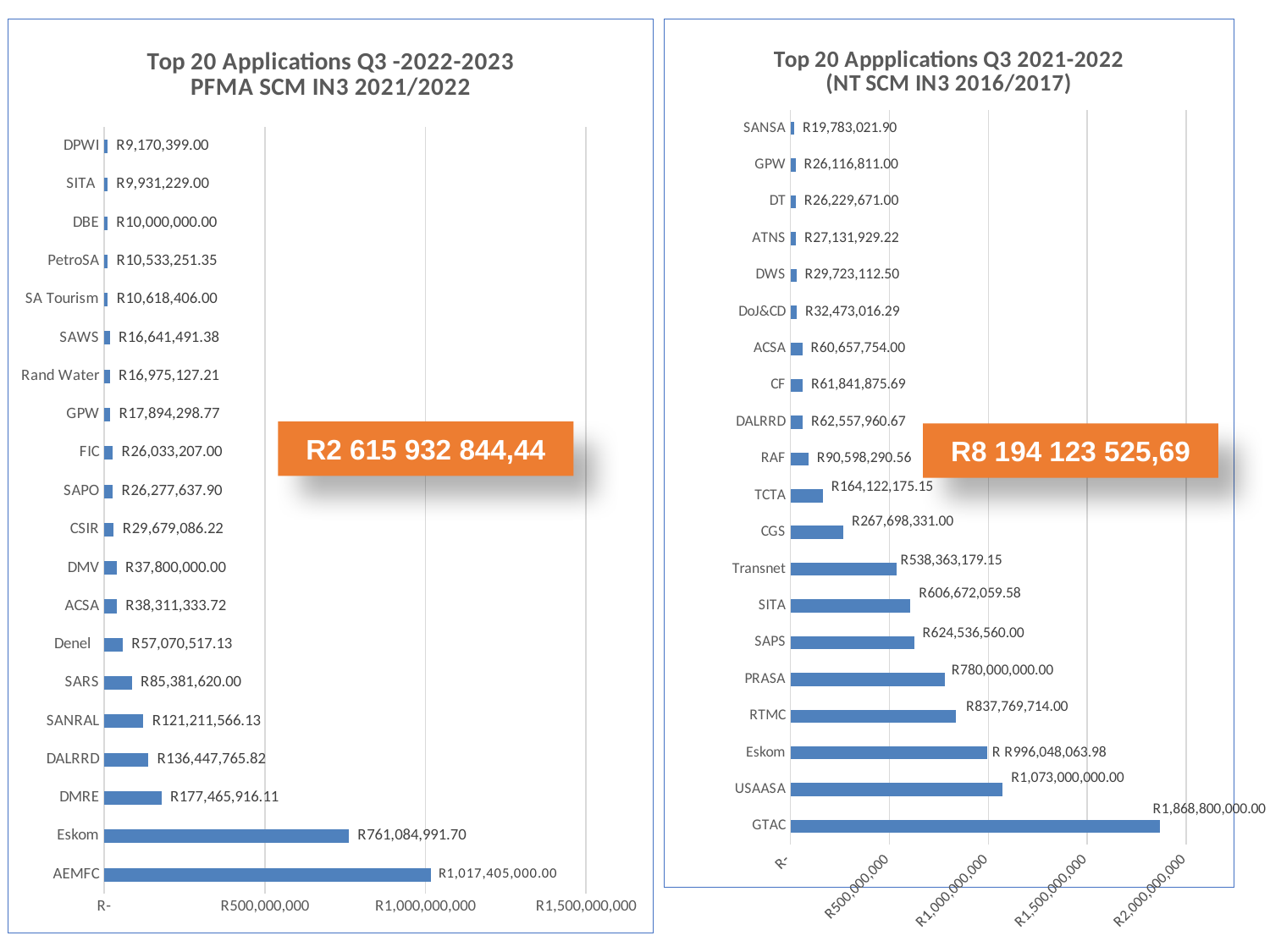
In the left chart, what is the difference between the values for AEMFC and Eskom? R256,320,008.30 In the left chart, is the value for DMRE greater or less than R500,000,000? less How many entities are plotted in the right chart? 20 In the left chart (Top 20 Applications Q3 2022-2023), what is the value for Eskom? R761,084,991.70 In the left chart, which entity has the highest value? AEMFC In the right chart, what is the difference between the values for GTAC and USAASA? R795,800,000.00 In the left chart, what is the value for SANRAL? R121,211,566.13 In the right chart (Top 20 Applications Q3 2021-2022), what is the value for USAASA? R1,073,000,000.00 What total is shown in the orange box on the right chart? R8 194 123 525,69 What kind of chart is the left chart? bar chart In the right chart, which is larger: the value for RTMC or the value for PRASA? RTMC In the right chart, which entity has the lowest value? SANSA